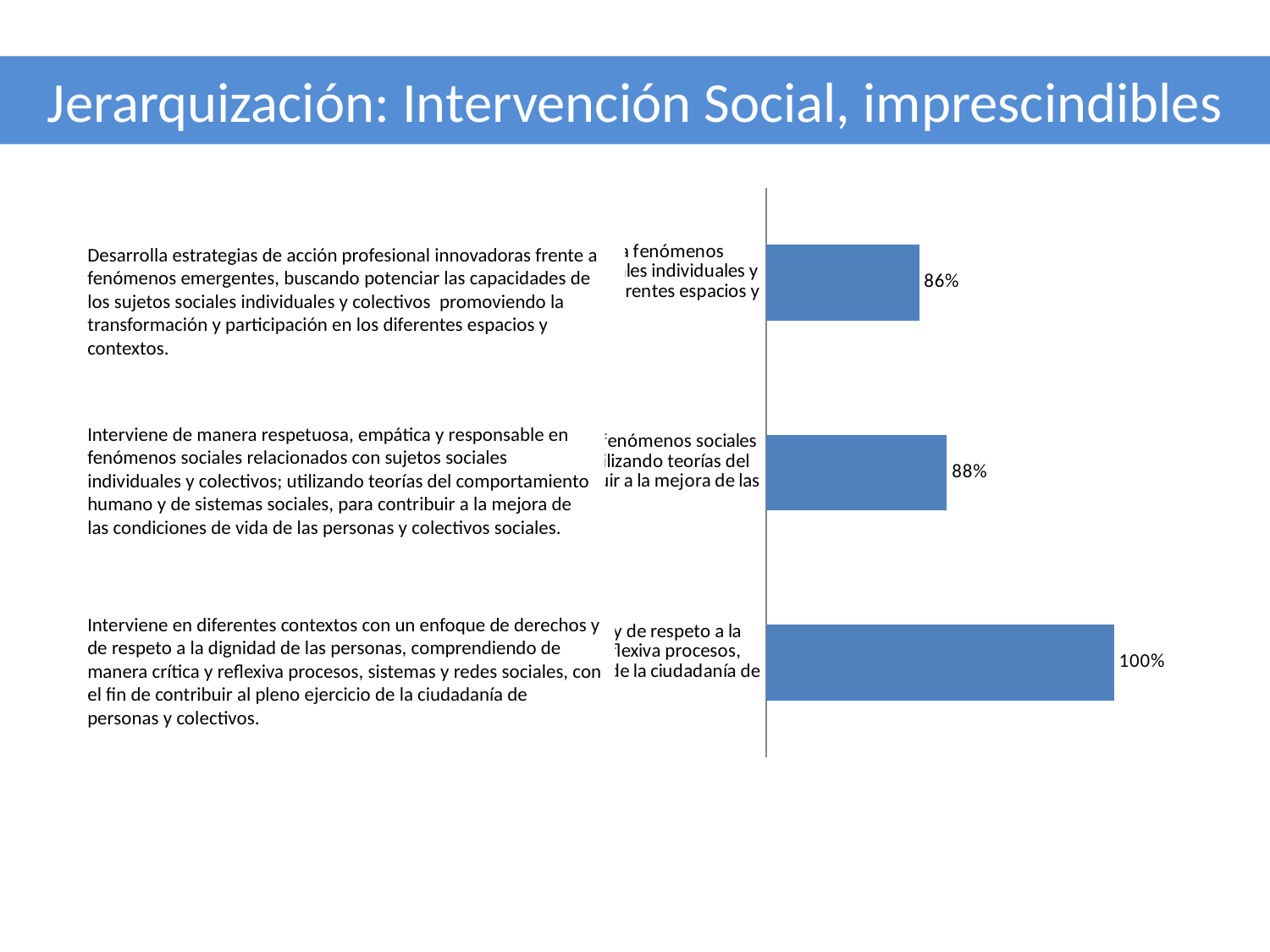
What type of chart is shown on the slide? bar chart What is the difference between the highest value (100%) and the lowest value (86%)? 14% Which is larger: the value for "Interviene de manera respetuosa..." or the value for "Desarrolla estrategias..."? Interviene de manera respetuosa... What colour are the bars in the chart? blue What is the value for the competency beginning "Interviene en diferentes contextos con un enfoque de derechos"? 100% How many bars are plotted in the chart? 3 What is the title of the slide containing the chart? Jerarquización: Intervención Social, imprescindibles Which competency has the highest value? Interviene en diferentes contextos con un enfoque de derechos y de respeto a la dignidad de las personas What is the value for the competency beginning "Desarrolla estrategias de acción profesional innovadoras"? 86% What is the value for the competency beginning "Interviene de manera respetuosa, empática y responsable"? 88% Which competency has the lowest value? Desarrolla estrategias de acción profesional innovadoras frente a fenómenos emergentes What is the difference between the value for "Interviene de manera respetuosa..." (88%) and "Desarrolla estrategias..." (86%)? 2%